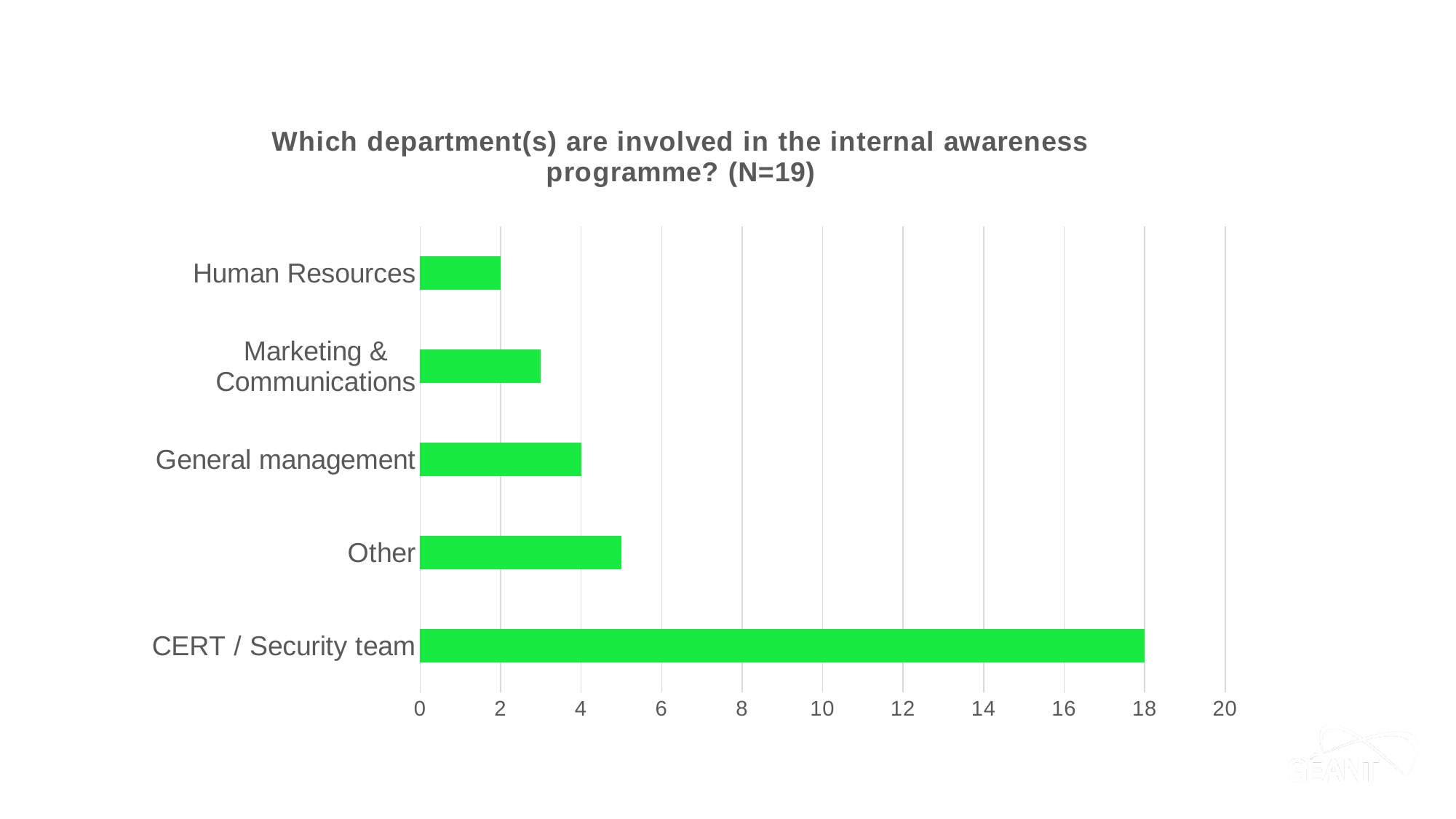
Is the value for Other greater or less than 4? greater What is the value for Human Resources? 2 What kind of chart is shown on the slide? bar chart Is the value for Marketing & Communications greater or less than 4? less Which department has the highest value? CERT / Security team What is the difference between the values for CERT / Security team and General management? 14 What is the N stated in the chart title? 19 What is the value for General management? 4 What is the value for CERT / Security team? 18 How many departments are listed on the chart? 5 Which is larger, the value for General management or the value for Human Resources? General management Which department has the lowest value? Human Resources